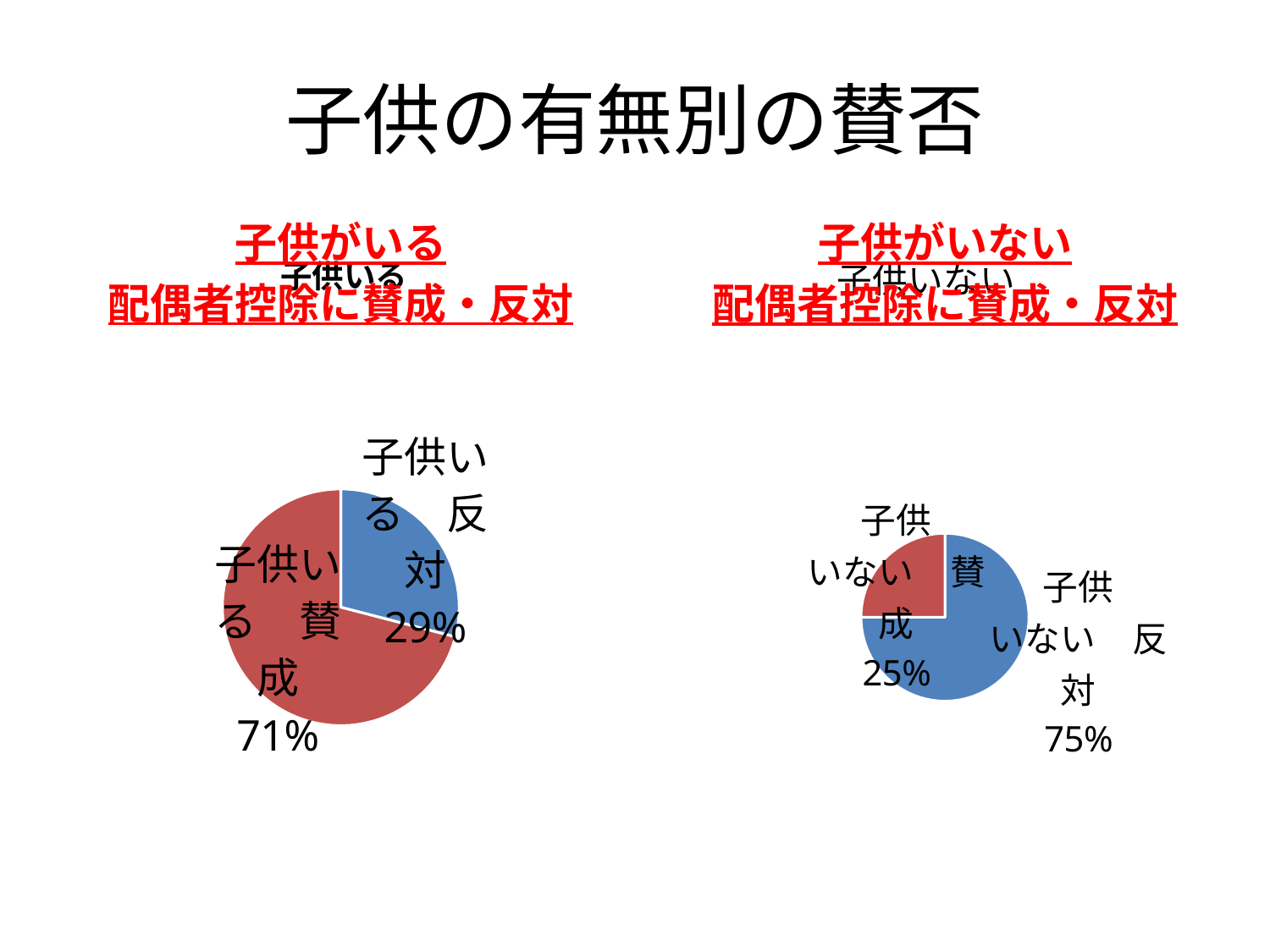
In the right pie chart (子供いない), what colour is the 反対 slice? Blue In the right pie chart (子供いない), which slice is the smallest? 子供いない 賛成 Which is larger: 賛成 in the left pie chart (子供いる) or 賛成 in the right pie chart (子供いない)? 賛成 in the left pie chart (子供いる) In the right pie chart (子供いない), what is the difference in percentage points between 反対 and 賛成? 50 How many slices does the left pie chart (子供いる) have? 2 In the left pie chart (子供いる), what percentage is shown for 子供いる 賛成? 71% In the right pie chart (子供いない), what percentage is shown for 子供いない 反対? 75% In the left pie chart (子供いる), what is the difference in percentage points between 賛成 and 反対? 42 In the right pie chart (子供いない), what percentage is shown for 子供いない 賛成? 25% In the left pie chart (子供いる), which slice is the largest? 子供いる 賛成 What type of chart is used on the right side of the slide (子供いない)? Pie chart In the left pie chart (子供いる), what percentage is shown for 子供いる 反対? 29%